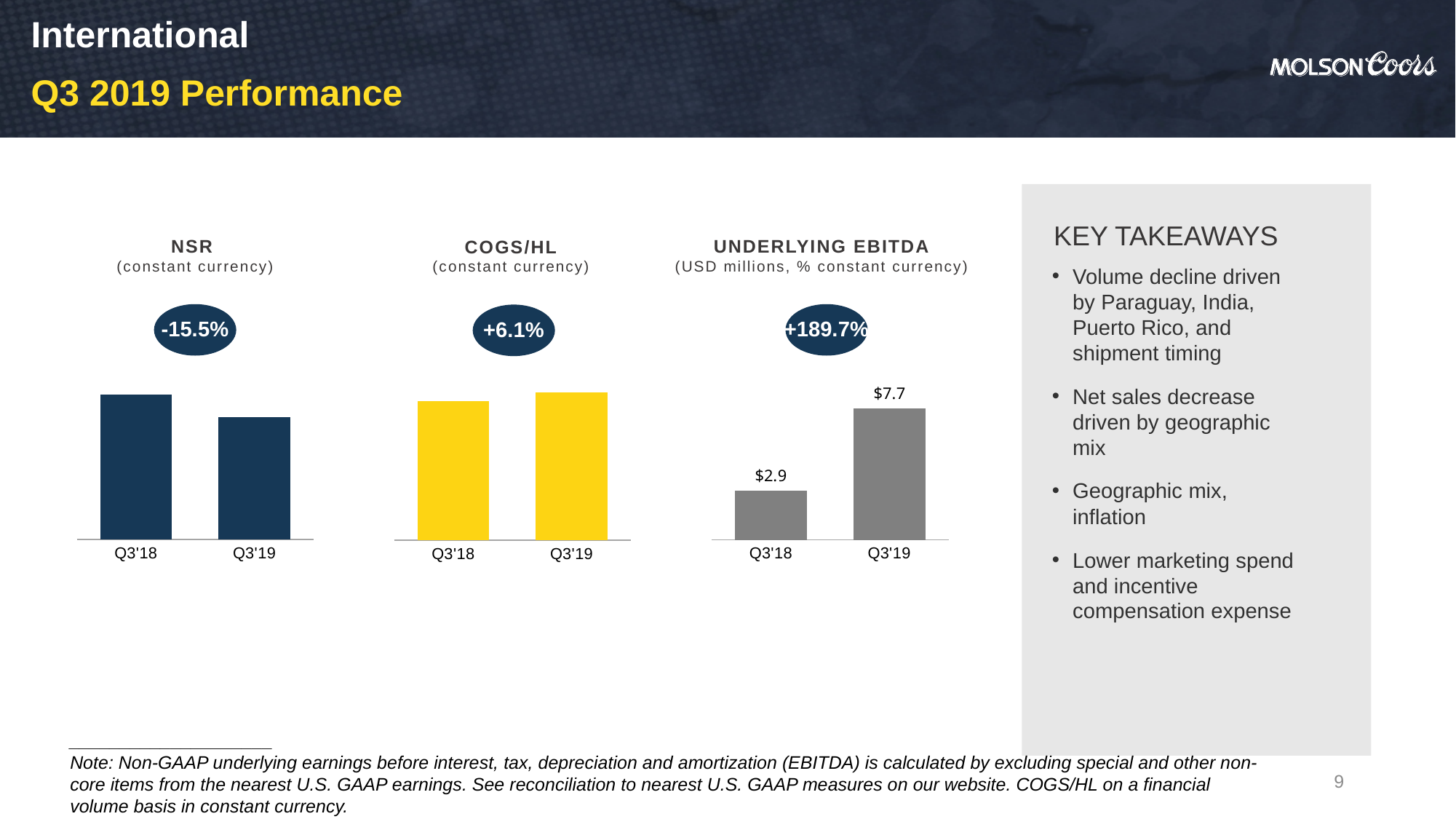
In the UNDERLYING EBITDA chart, what is the difference between the Q3'19 and Q3'18 values? $4.8 In the COGS/HL chart, is the Q3'19 bar taller or shorter than the Q3'18 bar? taller In the UNDERLYING EBITDA chart, what is the value for Q3'18? $2.9 In the NSR chart, do the values rise or fall from Q3'18 to Q3'19? fall What type of chart is the NSR chart? bar chart In the COGS/HL chart, do the values rise or fall from Q3'18 to Q3'19? rise In the UNDERLYING EBITDA chart, which quarter has the higher value? Q3'19 In the UNDERLYING EBITDA chart, what is the value for Q3'19? $7.7 What percentage change is shown above the NSR chart? -15.5% In the NSR chart, which quarter has the lower bar? Q3'19 What percentage change is shown above the UNDERLYING EBITDA chart? +189.7% How many bars are in the COGS/HL chart? 2